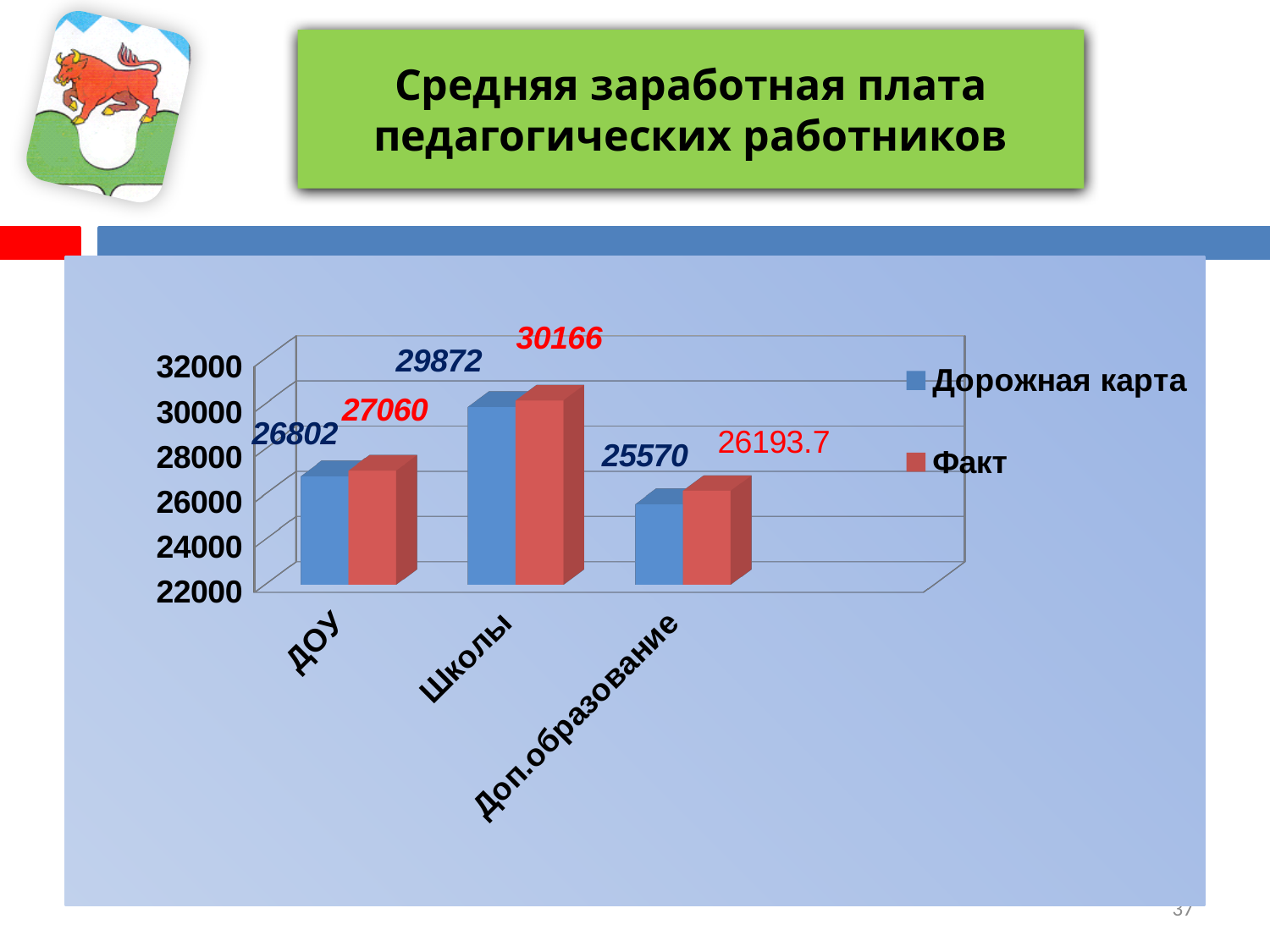
Which category has the highest Факт value? Школы What is the Дорожная карта value for ДОУ? 26802 What is the difference between the Факт and Дорожная карта values for Школы? 294 Which category has the lowest Дорожная карта value? Доп.образование What is the Факт value for Доп.образование? 26193.7 Which is larger for Школы: the Дорожная карта value or the Факт value? Факт How many categories are shown on the x axis? 3 What is the Факт value for Школы? 30166 What is the Дорожная карта value for Доп.образование? 25570 How many series does the legend list? 2 What is the difference between the Факт and Дорожная карта values for ДОУ? 258 What kind of chart is shown on the slide? Bar chart